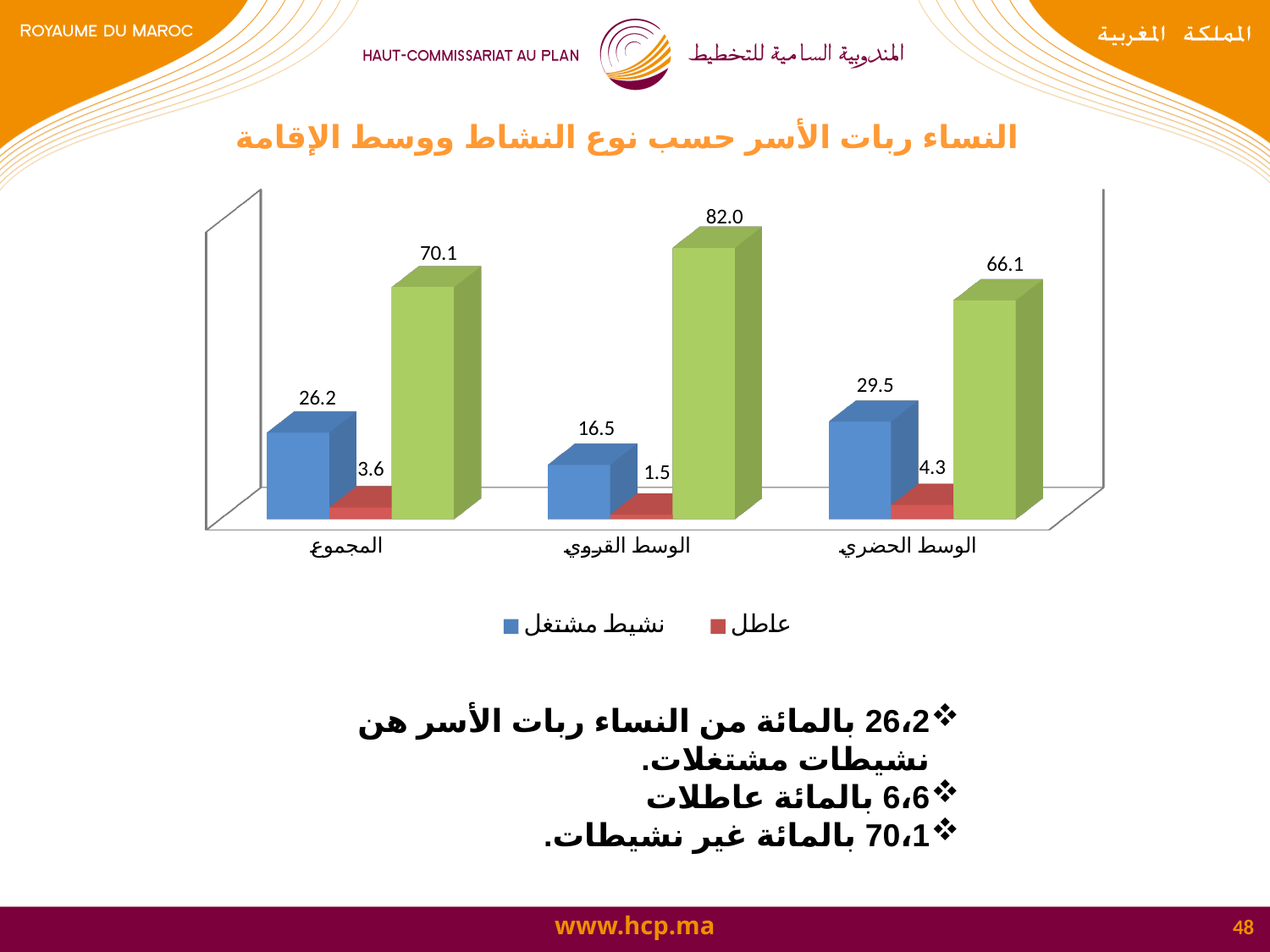
What is the value of عاطل for الوسط القروي? 1.5 Which is larger, the عاطل value for المجموع or for الوسط الحضري? الوسط الحضري What is the difference between the نشيط مشتغل values for الوسط الحضري and الوسط القروي? 13.0 What is the value of the green bar for الوسط القروي? 82.0 What kind of chart is shown on the slide? Bar chart What is the value of نشيط مشتغل for المجموع? 26.2 Which category has the highest value for نشيط مشتغل? الوسط الحضري What is the title of the chart? النساء ربات الأسر حسب نوع النشاط ووسط الإقامة What is the value of عاطل for الوسط الحضري? 4.3 Which category has the lowest value for عاطل? الوسط القروي What is the value of نشيط مشتغل for الوسط الحضري? 29.5 How many categories are shown on the x axis? 3